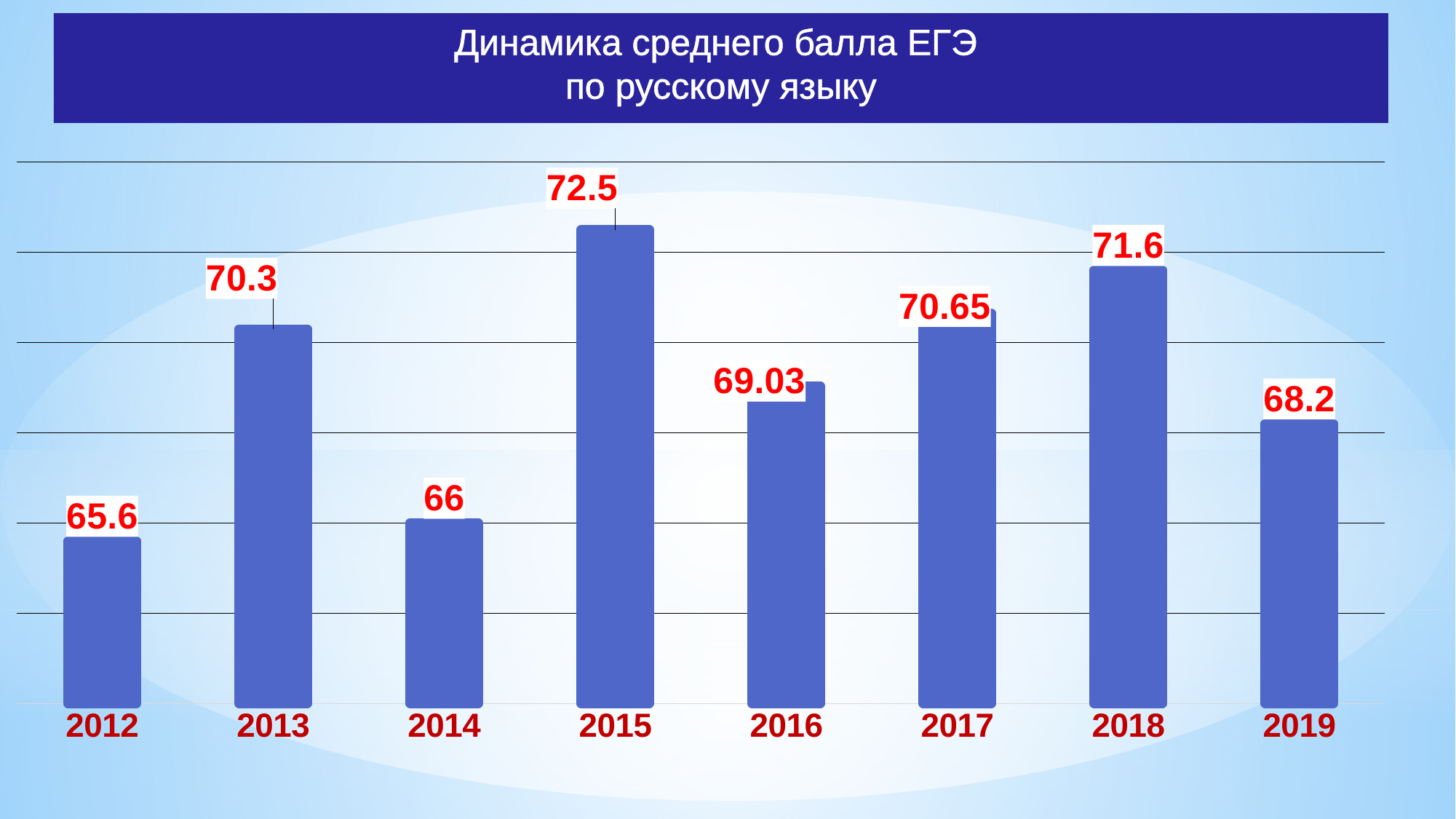
What is the difference between the scores for 2015 and 2012? 6.9 What is the average score for 2012? 65.6 Which year has a higher score, 2013 or 2016? 2013 What is the average score for 2017? 70.65 What kind of chart is shown on the slide? bar chart Which year has the lowest average score? 2012 What is the title of the chart? Динамика среднего балла ЕГЭ по русскому языку What is the difference between the scores for 2018 and 2019? 3.4 How many years are shown on the chart? 8 Which year has the highest average score? 2015 What is the average score for 2015? 72.5 What is the average score for 2019? 68.2